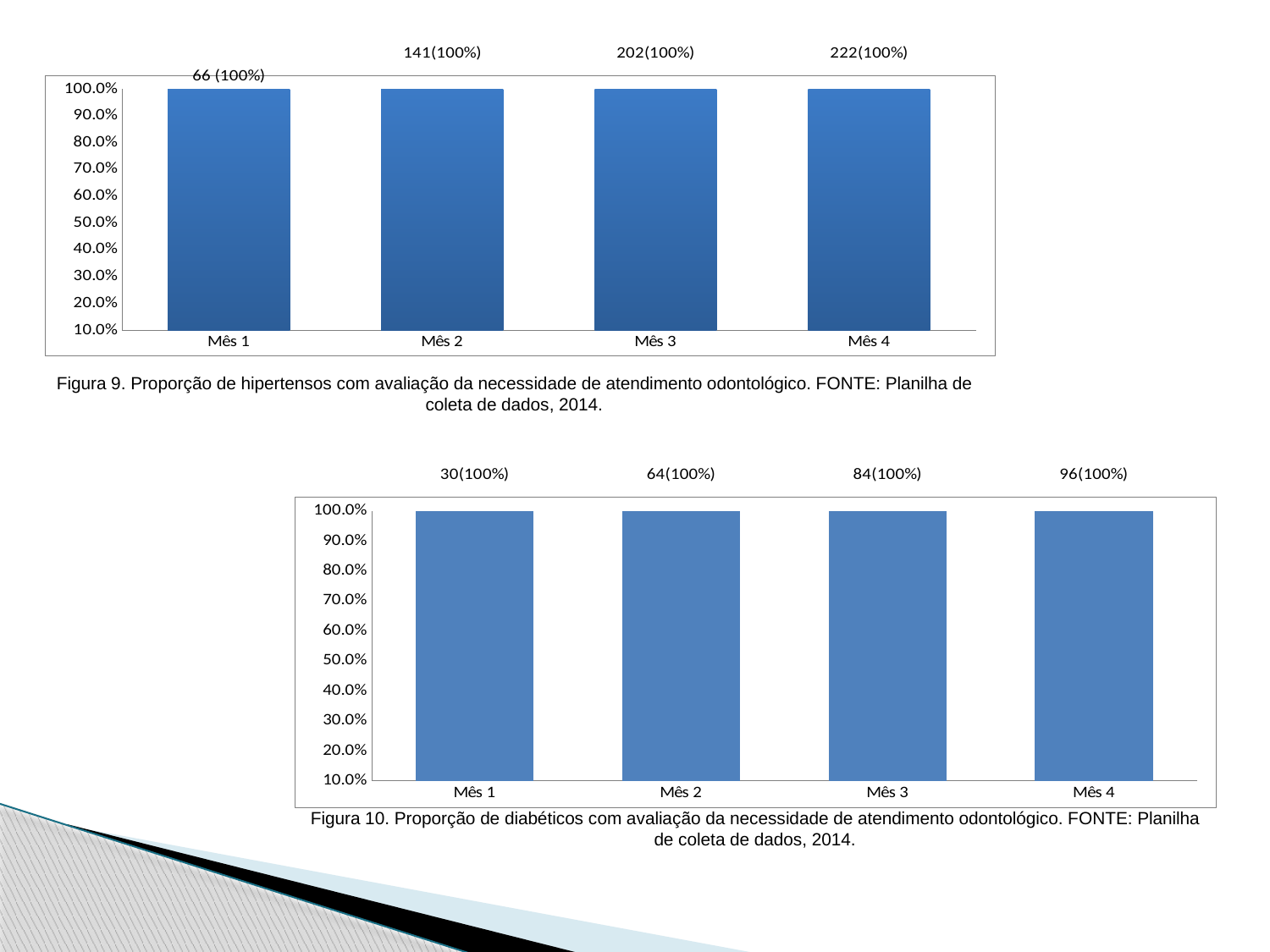
In the top chart (Figura 9), what is the data label shown above the bar for Mês 4? 222(100%) In the top chart (Figura 9), is the value for Mês 2 greater or less than 50.0%? greater In the top chart (Figura 9), what is the data label shown above the bar for Mês 1? 66 (100%) How many months (categories) are shown on the x axis of the top chart (Figura 9)? 4 In the top chart (Figura 9), what is the data label shown above the bar for Mês 3? 202(100%) In the bottom chart (Figura 10), what percentage does the bar for Mês 1 reach? 100% In the bottom chart (Figura 10), what is the data label shown above the bar for Mês 2? 64(100%) How many bars are plotted in the bottom chart (Figura 10)? 4 What type of chart is the top chart (Figura 9)? Bar chart According to the caption, what is the source (FONTE) of the data in the bottom chart (Figura 10)? Planilha de coleta de dados, 2014 In the bottom chart (Figura 10), what is the data label shown above the bar for Mês 4? 96(100%) In the bottom chart (Figura 10), do the bar values rise, fall, or stay the same from Mês 1 to Mês 4? Stay the same